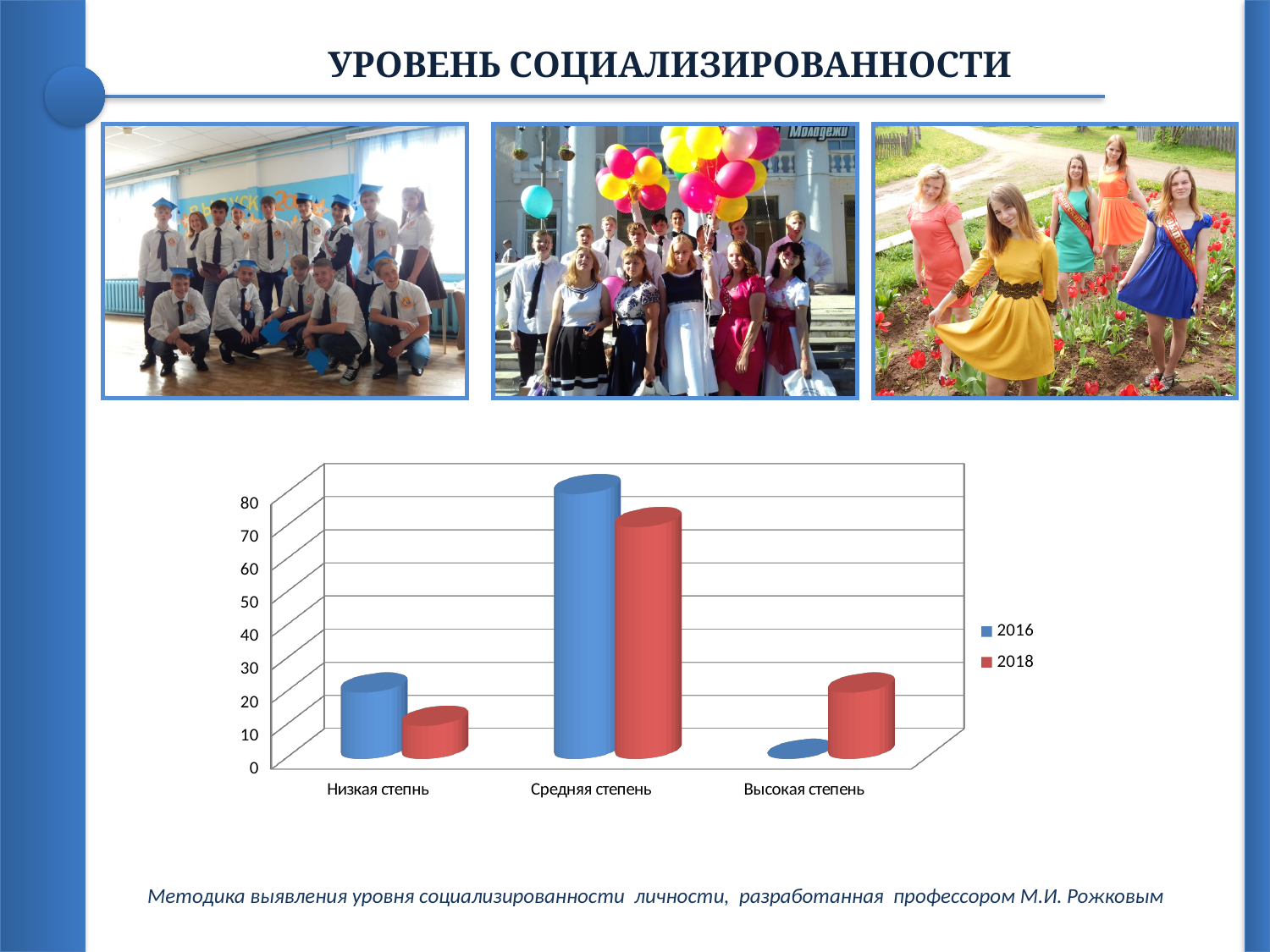
What kind of chart is shown on the slide? bar chart Which category has the highest value for the 2018 series? Средняя степень Is the value for Высокая степень in 2016 greater or less than 10? less Which category has the lowest value for the 2018 series? Низкая степнь For Высокая степень, which series has the larger value, 2016 or 2018? 2018 Which category has the lowest value for the 2016 series? Высокая степень Which category has the highest value for the 2016 series? Средняя степень What are the two series named in the chart legend? 2016 and 2018 How many categories are shown on the x axis of the chart? 3 Is the value for Средняя степень in 2016 greater or less than 50? greater For Низкая степнь, which series has the larger value, 2016 or 2018? 2016 How many series does the chart legend list? 2